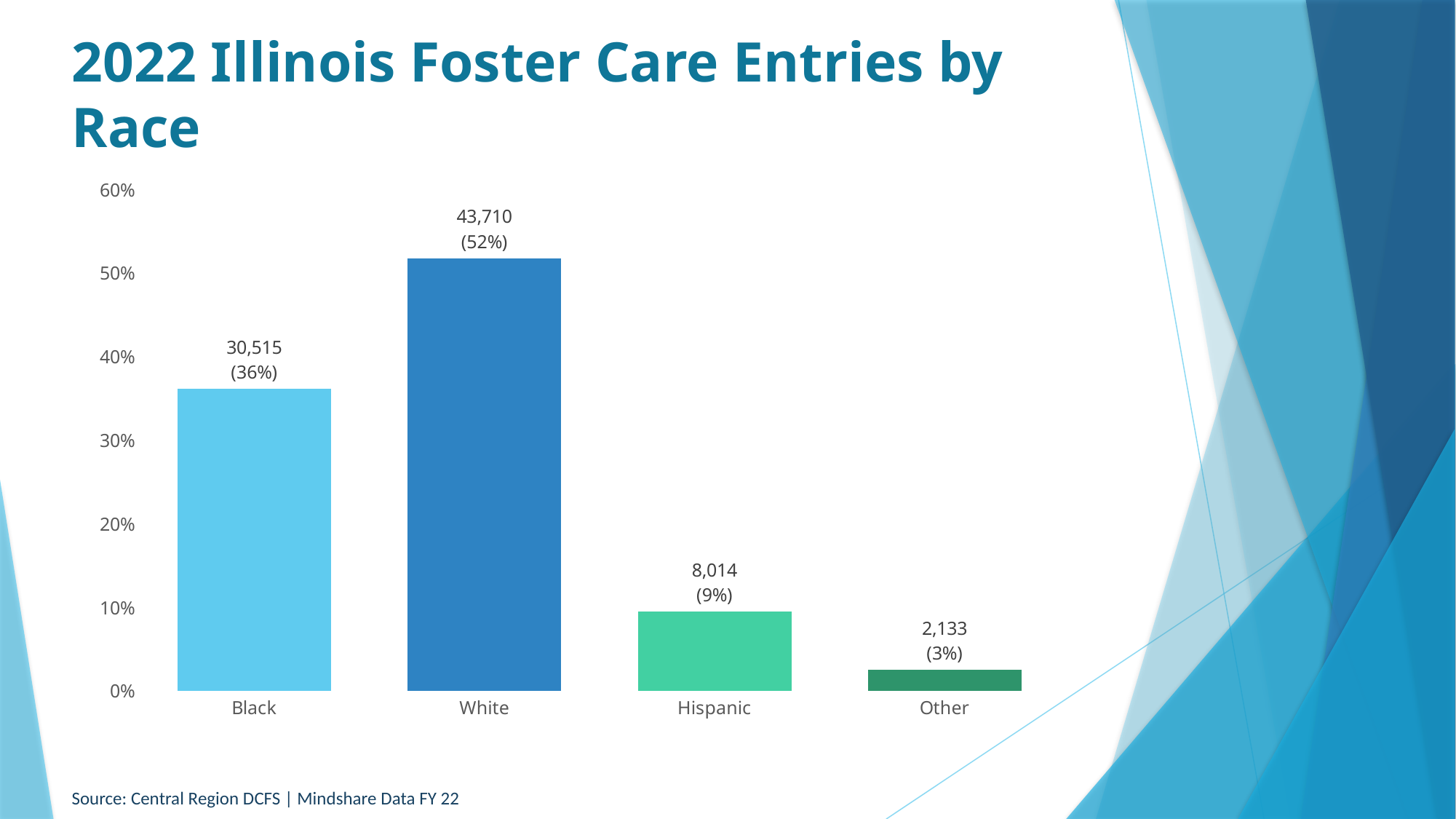
What is the number of foster care entries for Black children? 30,515 What percentage of foster care entries does the White category represent? 52% Which race category has the lowest number of foster care entries? Other How many race categories are shown in the chart? 4 What percentage of foster care entries does the Other category represent? 3% What is the title of the slide? 2022 Illinois Foster Care Entries by Race What is the number of foster care entries for the Hispanic category? 8,014 Which race category has the highest number of foster care entries? White Which category has more foster care entries, Hispanic or Other? Hispanic What is the difference in foster care entries between the White and Black categories? 13,195 Is the value for Black greater or less than 30%? greater What type of chart is shown on the slide? Bar chart